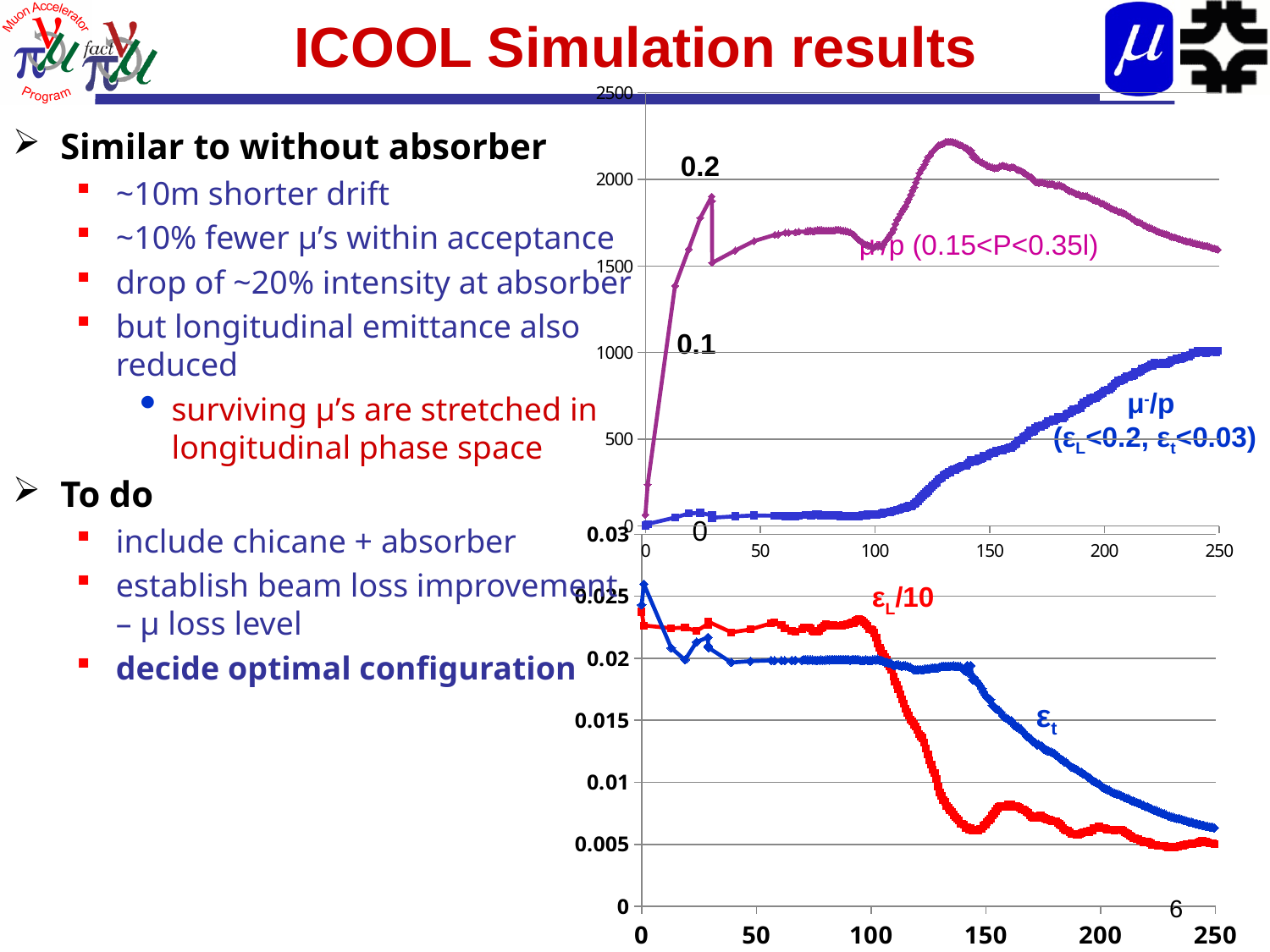
What kind of chart is the bottom chart on the slide? line chart In the top chart, which series is higher at x = 250, μ⁻/p (0.15<P<0.35) or μ⁻/p (εL<0.2, εt<0.03)? μ⁻/p (0.15<P<0.35) In the top chart, is the peak value of the μ⁻/p (0.15<P<0.35) series greater or less than 2000? greater In the top chart, is the value of the μ⁻/p (εL<0.2, εt<0.03) series at x = 100 greater or less than 500? less How many data series are plotted in the bottom chart? 2 In the bottom chart, does the εL/10 series generally rise or fall from x = 100 to x = 250? fall In the top chart, does the μ⁻/p (εL<0.2, εt<0.03) series generally rise or fall from x = 100 to x = 250? rise How many data series are plotted in the top chart? 2 In the bottom chart, is the value of the εL/10 series at x = 200 greater or less than 0.01? less In the bottom chart, which series is higher at x = 250, εL/10 or εt? εt What kind of chart is the top chart on the slide? line chart